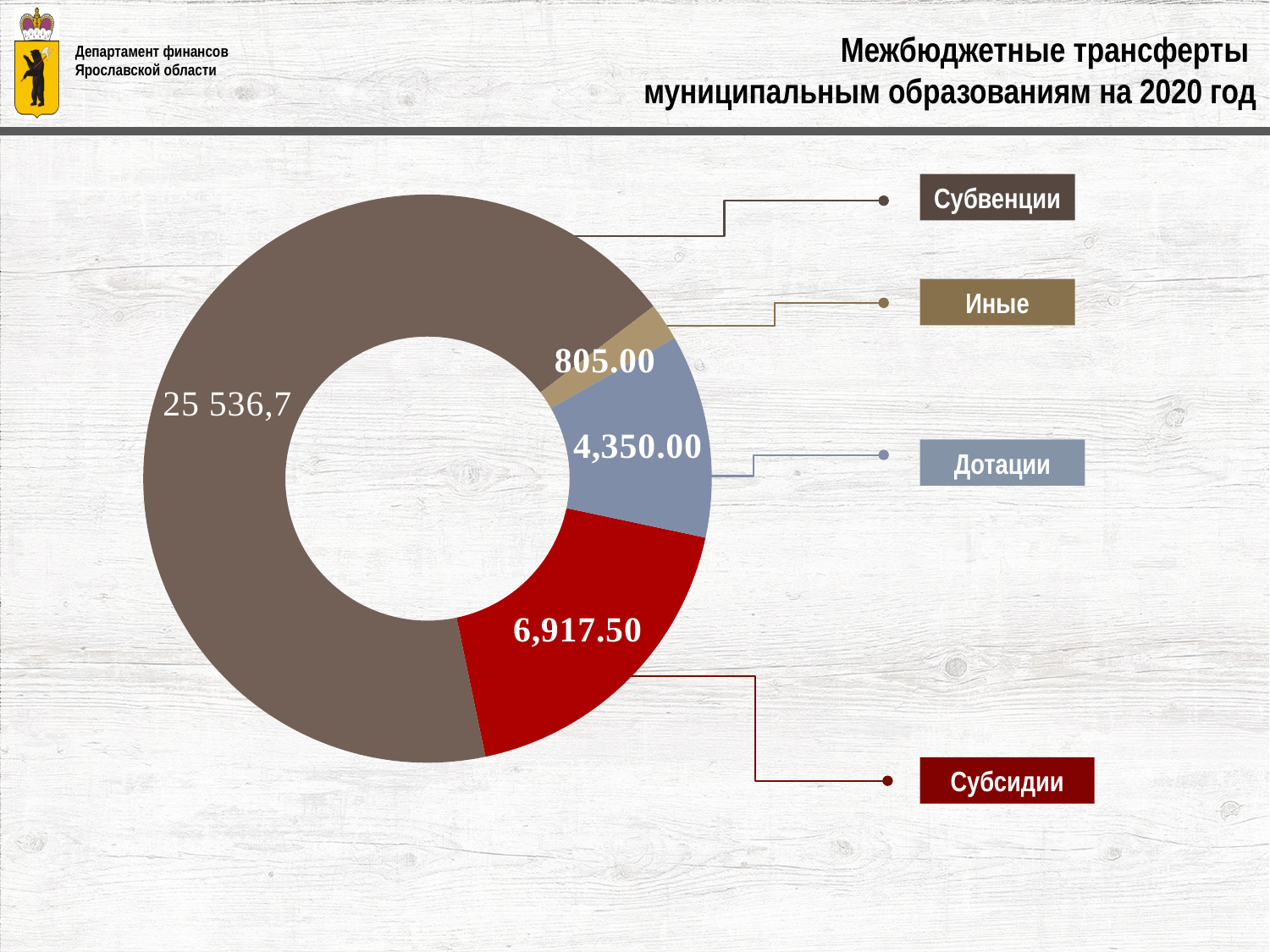
What type of chart is shown on the slide? Doughnut (pie) chart What is the difference between the values for Дотации and Иные? 3,545.00 What is the difference between the values for Субсидии and Дотации? 2,567.50 Which is larger, Субсидии or Дотации? Субсидии Which category has the smallest segment in the chart? Иные What is the value shown for Субвенции? 25 536,7 What is the value shown for Дотации? 4,350.00 What is the value shown for Субсидии? 6,917.50 How many categories are shown in the chart? 4 What colour is the segment for Субсидии? Red Which category has the largest segment in the chart? Субвенции What is the value shown for Иные? 805.00